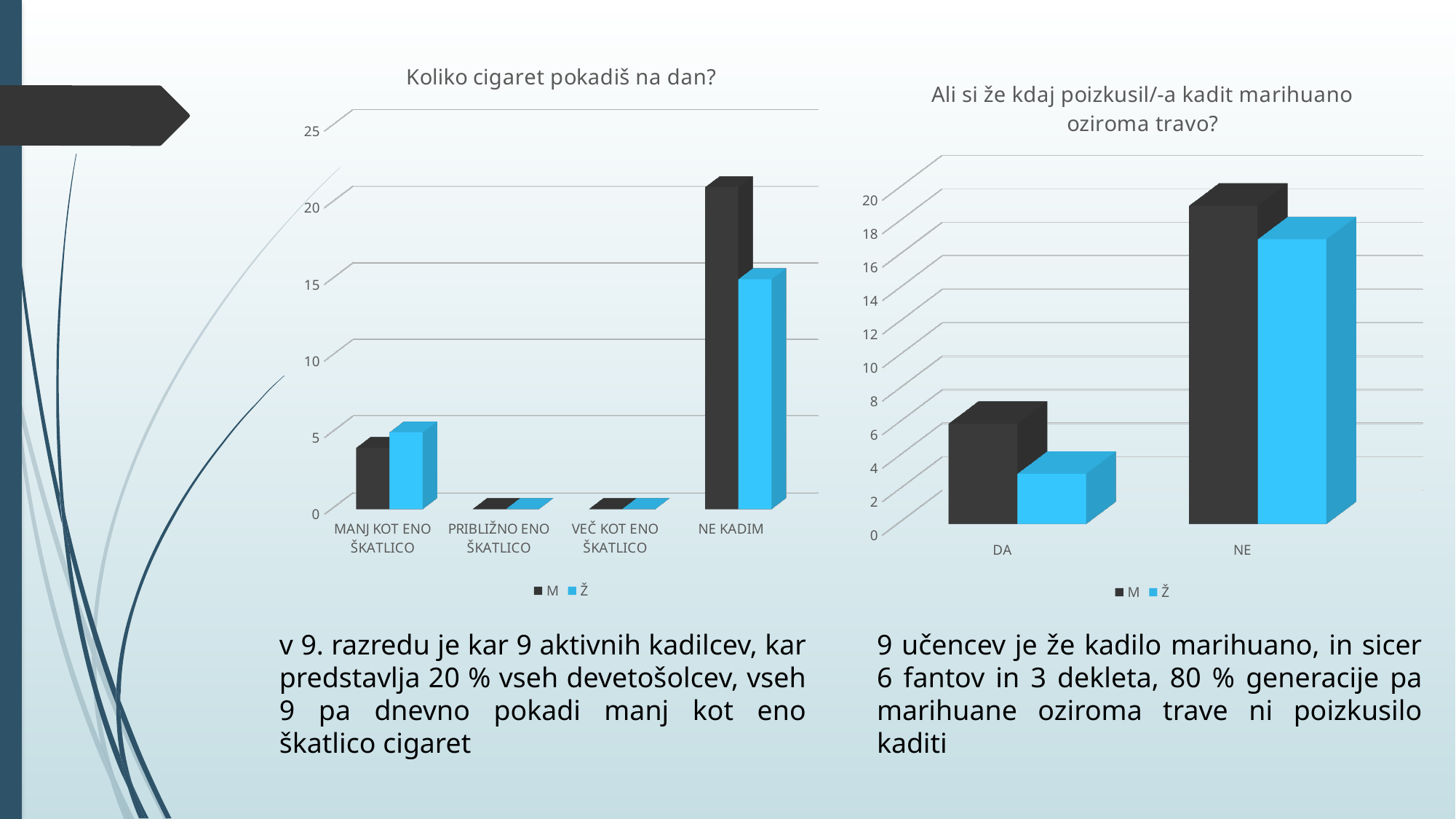
How many series does the legend list in the chart titled "Ali si že kdaj poizkusil/-a kadit marihuano oziroma travo?"? 2 In the chart titled "Koliko cigaret pokadiš na dan?", which is larger for NE KADIM, M or Ž? M In the chart titled "Koliko cigaret pokadiš na dan?", which category has the highest values? NE KADIM In the chart titled "Ali si že kdaj poizkusil/-a kadit marihuano oziroma travo?", is the value for Ž in the DA category greater or less than 5? less In the chart titled "Ali si že kdaj poizkusil/-a kadit marihuano oziroma travo?", which category has the higher values, DA or NE? NE What type of chart is the chart titled "Koliko cigaret pokadiš na dan?"? bar chart How many categories are shown on the x axis of the chart titled "Koliko cigaret pokadiš na dan?"? 4 In the chart titled "Ali si že kdaj poizkusil/-a kadit marihuano oziroma travo?", which is larger for DA, M or Ž? M What colour represents the series Ž in the chart titled "Koliko cigaret pokadiš na dan?"? light blue In the chart titled "Koliko cigaret pokadiš na dan?", is the value for M in the MANJ KOT ENO ŠKATLICO category greater or less than 10? less In the chart titled "Ali si že kdaj poizkusil/-a kadit marihuano oziroma travo?", is the value for M in the NE category greater or less than 15? greater